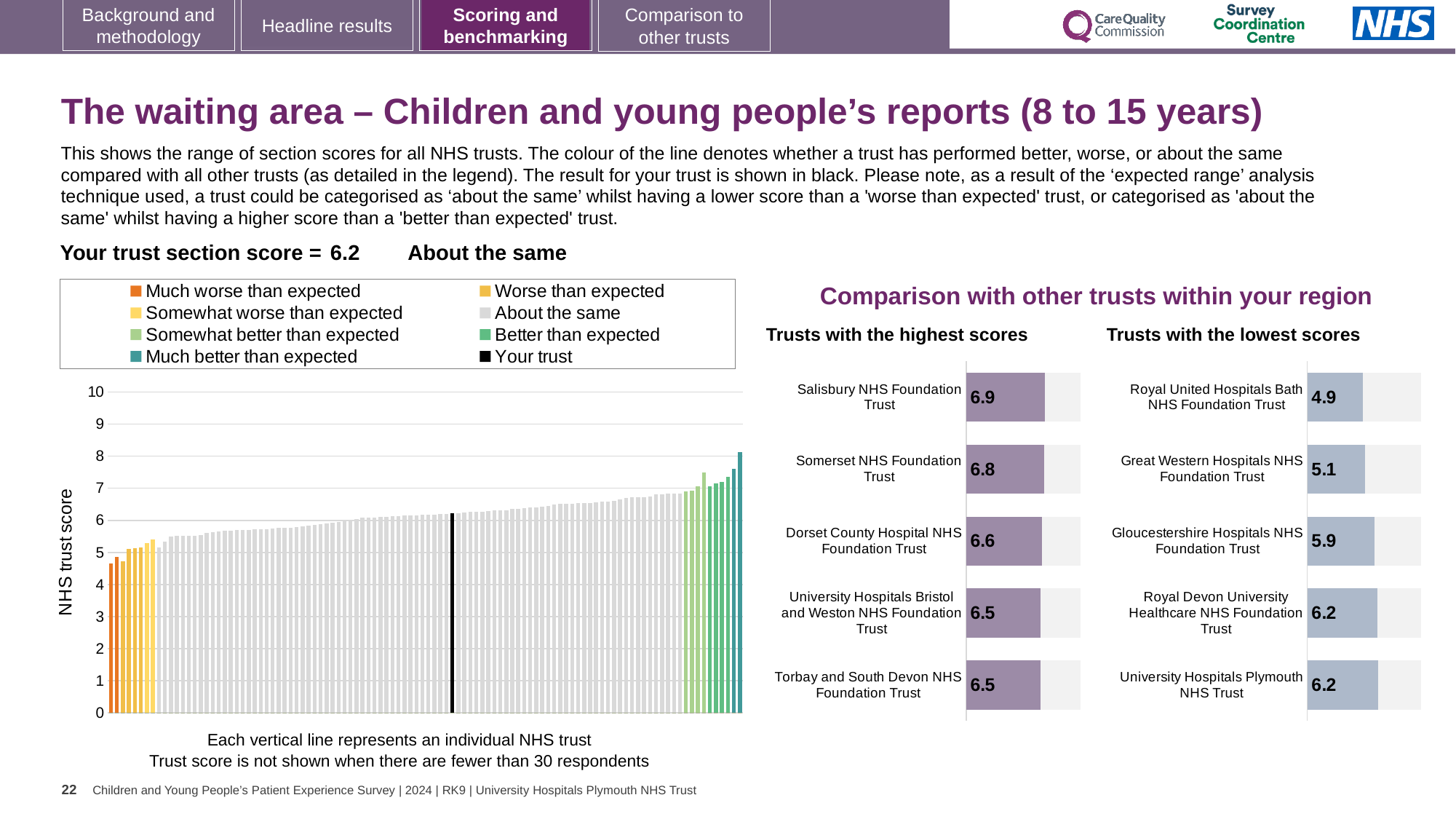
In the 'Trusts with the highest scores' chart, what is the difference between the scores of Salisbury NHS Foundation Trust and Dorset County Hospital NHS Foundation Trust? 0.3 In the 'Trusts with the lowest scores' chart, which has the larger score: Great Western Hospitals NHS Foundation Trust or Gloucestershire Hospitals NHS Foundation Trust? Gloucestershire Hospitals NHS Foundation Trust In the 'Trusts with the lowest scores' chart, what is the score for Gloucestershire Hospitals NHS Foundation Trust? 5.9 In the 'Trusts with the highest scores' chart, what is the score for Dorset County Hospital NHS Foundation Trust? 6.6 In the 'Trusts with the highest scores' chart, which trust has the highest score? Salisbury NHS Foundation Trust What kind of chart is the 'NHS trust score' chart on the left of the slide? Bar chart How many entries does the legend above the 'NHS trust score' chart list? 8 In the 'NHS trust score' chart on the left, do the bar values rise or fall from left to right? Rise In the 'Trusts with the lowest scores' chart, which trust has the lowest score? Royal United Hospitals Bath NHS Foundation Trust In the 'Trusts with the highest scores' chart, what is the score for Salisbury NHS Foundation Trust? 6.9 In the 'Trusts with the lowest scores' chart, what is the score for Royal United Hospitals Bath NHS Foundation Trust? 4.9 How many trusts are listed in the 'Trusts with the lowest scores' chart? 5